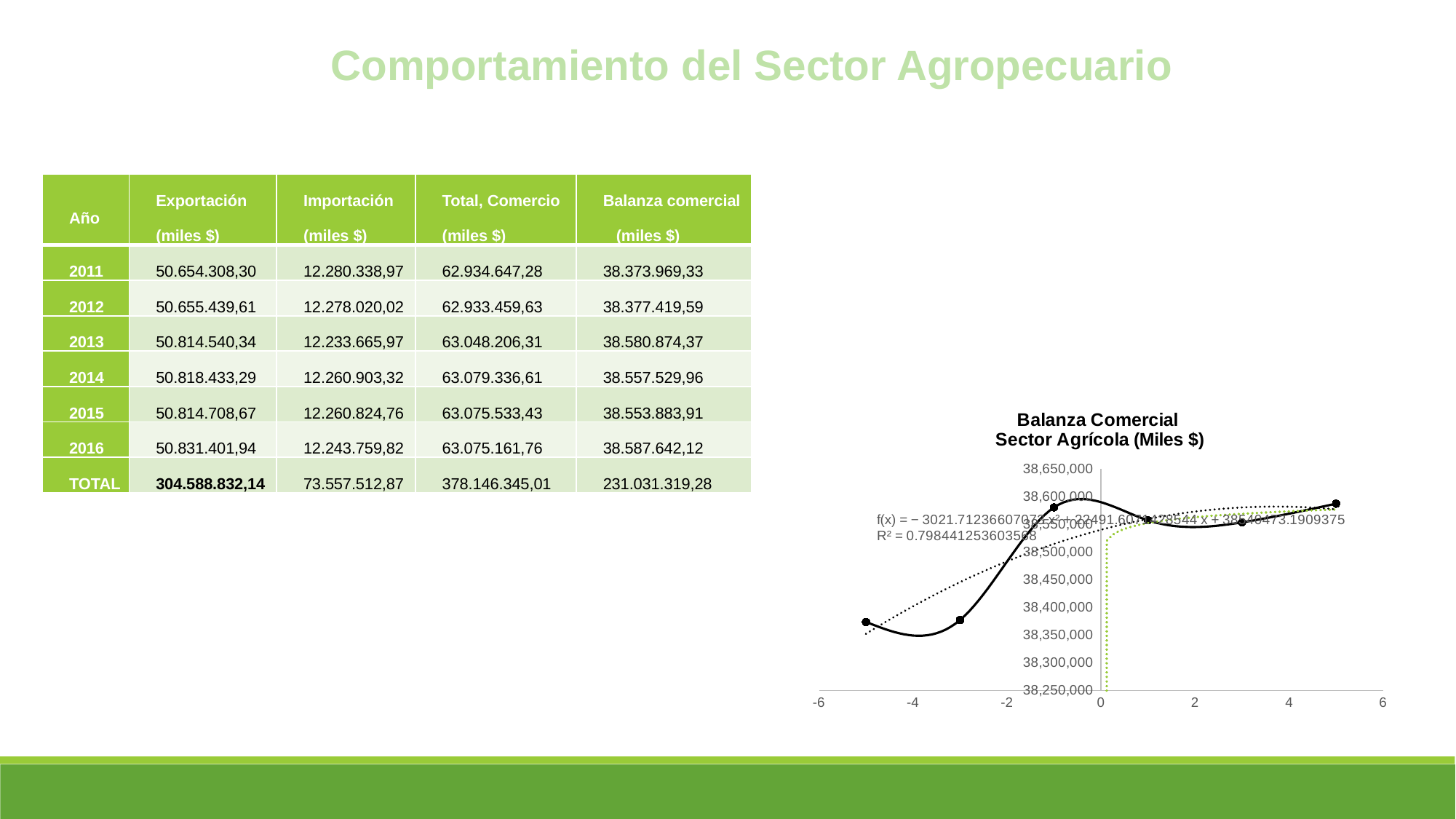
What kind of chart is the 'Balanza Comercial Sector Agrícola' chart? line chart On the 'Balanza Comercial Sector Agrícola' chart, is the value of the point at x = -5 greater or less than 38,400,000? less On the 'Balanza Comercial Sector Agrícola' chart, is the value of the point at x = 5 greater or less than 38,500,000? greater On the 'Balanza Comercial Sector Agrícola' chart, is the value of the point at x = -1 greater or less than 38,550,000? greater What is the highest value shown on the y axis of the 'Balanza Comercial Sector Agrícola' chart? 38,650,000 On the 'Balanza Comercial Sector Agrícola' chart, do the plotted values generally rise or fall from left to right along the x axis? rise How many data points are plotted on the 'Balanza Comercial Sector Agrícola' chart? 6 On the 'Balanza Comercial Sector Agrícola' chart, which point has the larger value: the one at x = -5 or the one at x = 5? x = 5 On the 'Balanza Comercial Sector Agrícola' chart, which point has the larger value: the one at x = -3 or the one at x = -1? x = -1 What is the title of the chart on the right of the slide? Balanza Comercial Sector Agrícola (Miles $)